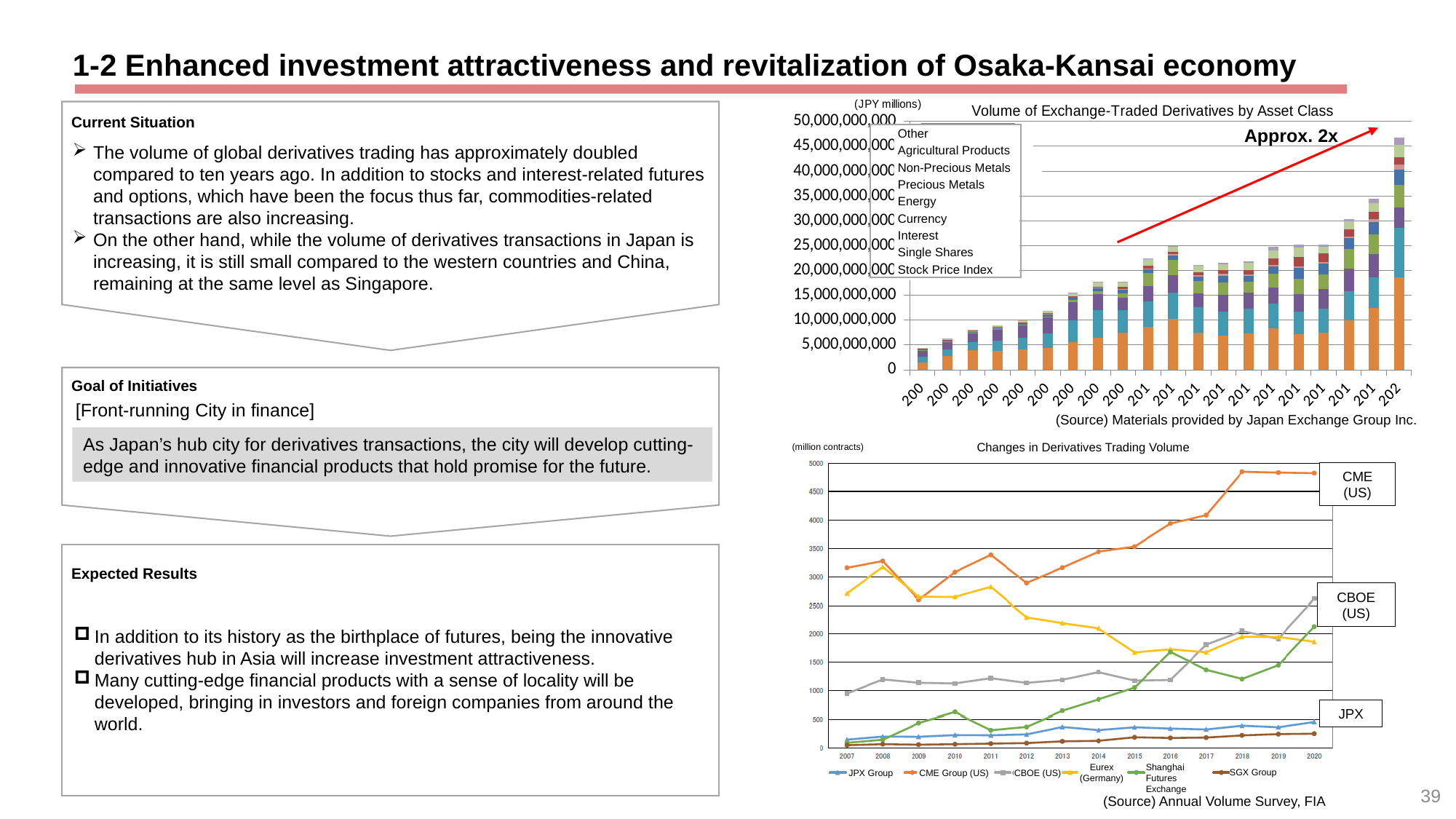
What kind of chart is the 'Volume of Exchange-Traded Derivatives by Asset Class' chart? Bar chart (stacked) How many series does the legend of the 'Changes in Derivatives Trading Volume' chart list? 6 What annotation is written next to the red arrow on the 'Volume of Exchange-Traded Derivatives by Asset Class' chart? Approx. 2x In the 'Changes in Derivatives Trading Volume' chart, which series has the highest value in 2020? CME Group (US) In the 'Volume of Exchange-Traded Derivatives by Asset Class' chart, is the total of the last (rightmost) bar greater or less than 40,000,000,000? greater In the 'Changes in Derivatives Trading Volume' chart, is the value for JPX Group in 2020 greater or less than 1000? less In the 'Changes in Derivatives Trading Volume' chart, does the CME Group (US) line overall rise or fall from 2007 to 2020? Rise In the 'Changes in Derivatives Trading Volume' chart, which is larger in 2020: CBOE (US) or Shanghai Futures Exchange? CBOE (US) In the 'Changes in Derivatives Trading Volume' chart, is the value for CME Group (US) in 2020 greater or less than 4500? greater What kind of chart is the 'Changes in Derivatives Trading Volume' chart? Line chart How many series does the legend of the 'Volume of Exchange-Traded Derivatives by Asset Class' chart list? 9 How many years are shown on the x axis of the 'Changes in Derivatives Trading Volume' chart? 14